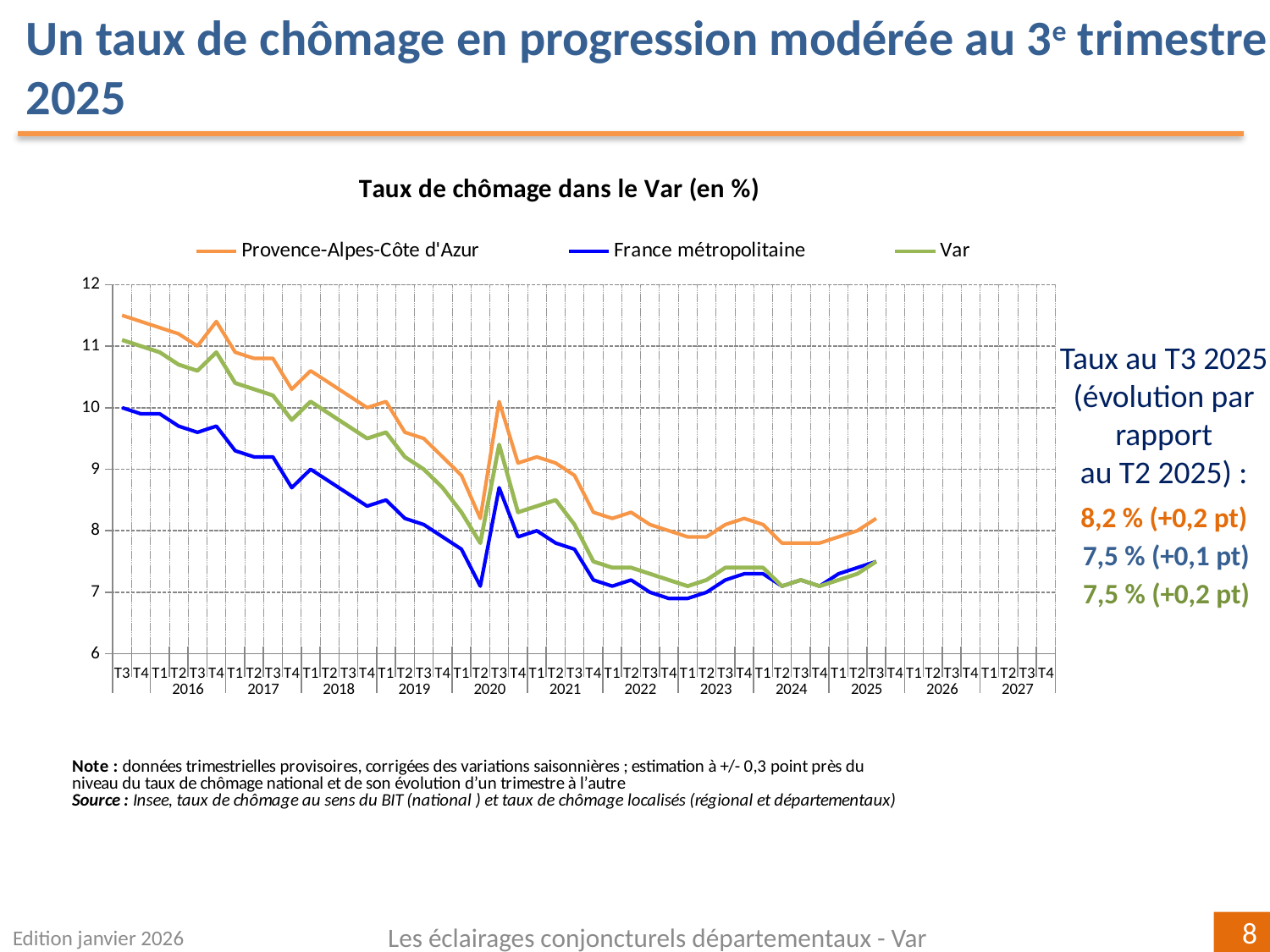
What is the unemployment rate for the Var at T3 2025? 7,5 % How many series does the legend list? 3 Is the value for Provence-Alpes-Côte d'Azur at T1 2016 greater or less than 11? greater By how much did the Var unemployment rate change between T2 2025 and T3 2025? +0,2 pt What is the unemployment rate for France métropolitaine at T3 2025? 7,5 % What is the unemployment rate for Provence-Alpes-Côte d'Azur at T3 2025? 8,2 % What is the difference between the Provence-Alpes-Côte d'Azur rate and the Var rate at T3 2025? 0,7 pt What is the title of the chart? Taux de chômage dans le Var (en %) What kind of chart is shown on the slide? line chart Overall, do the unemployment rates rise or fall between 2016 and 2025? fall Is the value for France métropolitaine at T2 2020 greater or less than 8? less Which series has the highest value at T3 2025? Provence-Alpes-Côte d'Azur